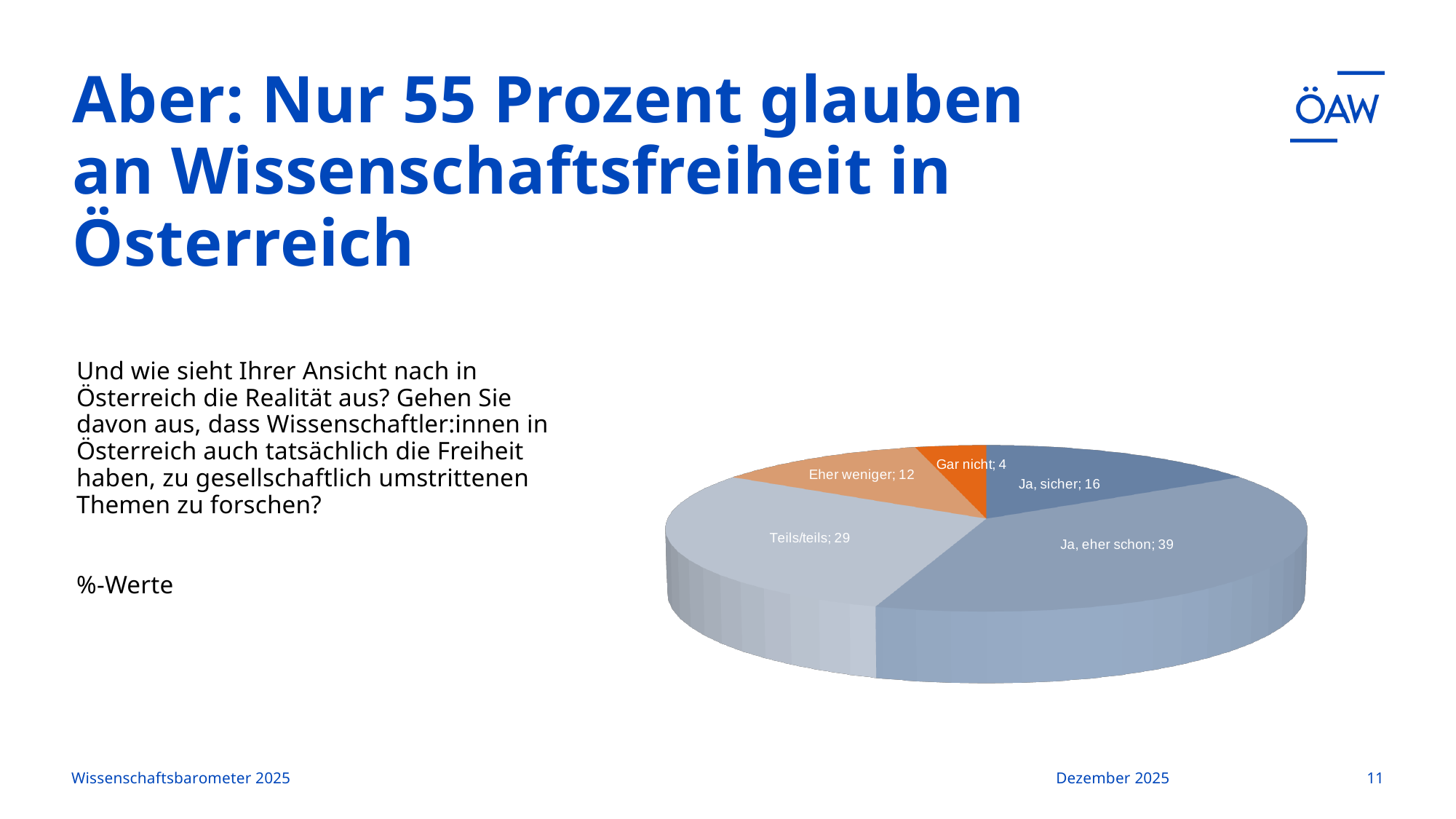
Which category has the smallest slice? Gar nicht What is the combined value of "Ja, sicher" and "Ja, eher schon"? 55 Which category has the largest slice? Ja, eher schon What is the value for "Teils/teils"? 29 How many categories does the pie chart show? 5 What is the difference between the values for "Ja, eher schon" and "Teils/teils"? 10 Which is larger, the value for "Ja, sicher" or the value for "Eher weniger"? Ja, sicher What is the value for "Ja, sicher"? 16 What is the value for "Eher weniger"? 12 What is the value for "Ja, eher schon"? 39 What is the value for "Gar nicht"? 4 What kind of chart is shown on the slide? pie chart